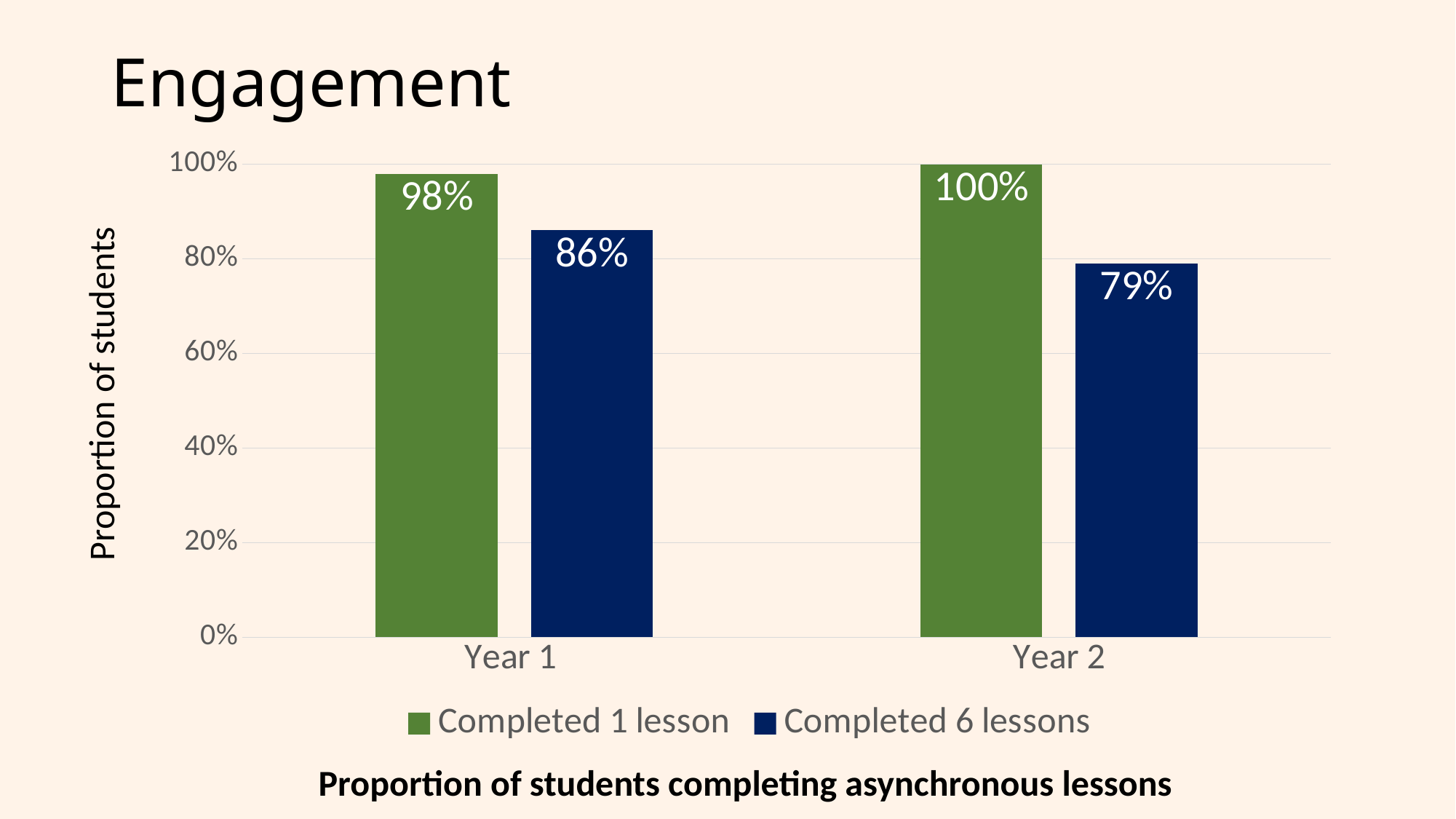
Which is larger: the Year 1 or the Year 2 value for Completed 6 lessons? Year 1 Which bar shows the lowest value on the chart? Completed 6 lessons, Year 2 What is the label on the vertical axis of the chart? Proportion of students What proportion of students completed 1 lesson in Year 1? 98% What is the difference between the Year 1 and Year 2 values for Completed 6 lessons? 7% What proportion of students completed 1 lesson in Year 2? 100% What proportion of students completed 6 lessons in Year 1? 86% What proportion of students completed 6 lessons in Year 2? 79% How many series does the legend list? 2 What kind of chart is shown on the slide? Bar chart Which bar shows the highest value on the chart? Completed 1 lesson, Year 2 What is the difference between the proportion completing 1 lesson and the proportion completing 6 lessons in Year 1? 12%